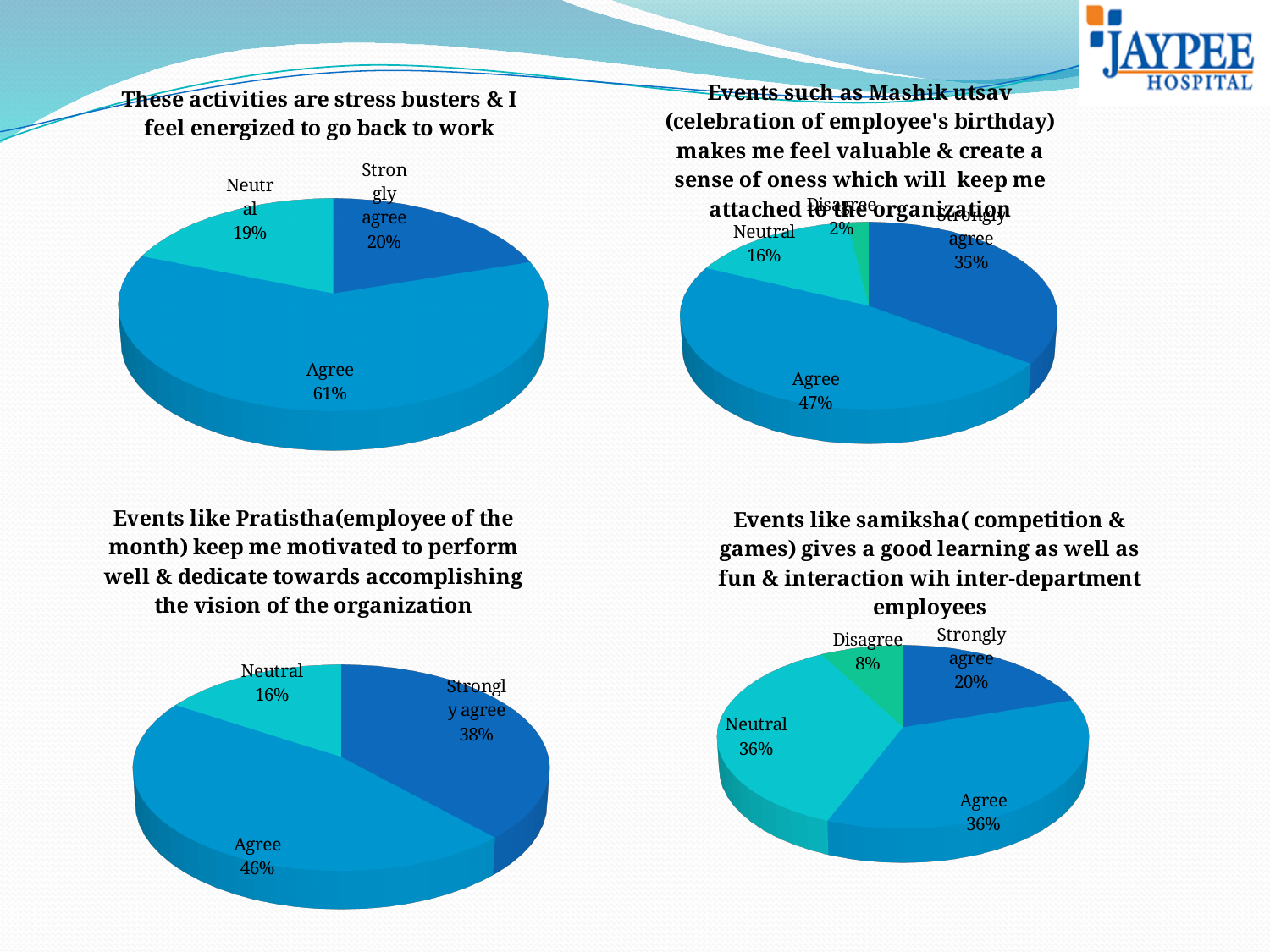
In the bottom-left pie chart (Pratistha), what share of respondents chose Strongly agree? 38% In the bottom-right pie chart (samiksha), what is the difference between the Neutral and Strongly agree shares? 16% In the top-right pie chart (Mashik utsav), which response has the largest share? Agree What type of chart is used for the bottom-right chart (samiksha)? Pie chart In the top-right pie chart (Mashik utsav), what is the difference between the Agree and Strongly agree shares? 12% In the top-left pie chart (stress busters), how many slices does the pie have? 3 In the top-right pie chart (Mashik utsav), what share of respondents chose Disagree? 2% In the bottom-left pie chart (Pratistha), which is larger, Agree or Strongly agree? Agree In the bottom-right pie chart (samiksha), what share of respondents chose Disagree? 8% In the top-left pie chart (stress busters), which response has the smallest share? Neutral In the top-left pie chart (stress busters), what share of respondents chose Agree? 61% In the bottom-right pie chart (samiksha), how many slices does the pie have? 4